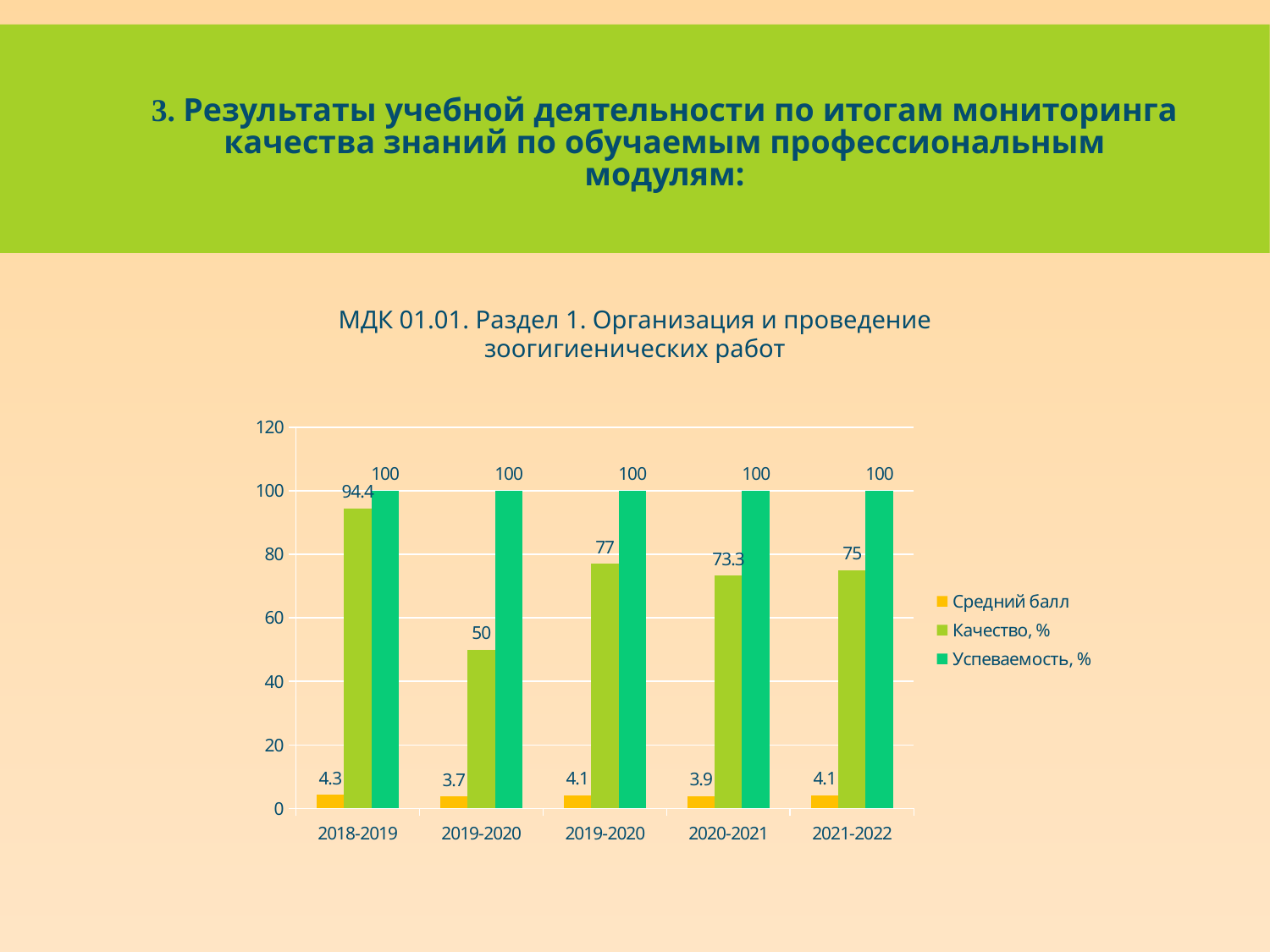
Which is larger, Качество, % for 2020-2021 or for 2021-2022? 2021-2022 What is the lowest value of Средний балл shown on the chart? 3.7 What is the value of Успеваемость, % for 2020-2021? 100 What is the Средний балл for 2021-2022? 4.1 How many series does the legend list? 3 What is the value of Качество, % for 2020-2021? 73.3 What is the value of Качество, % for 2018-2019? 94.4 What is the difference between Качество, % for 2018-2019 and for 2021-2022? 19.4 How many categories are shown on the x axis? 5 What is the difference between Средний балл for 2018-2019 and for 2020-2021? 0.4 Which category has the highest value of Качество, %? 2018-2019 What type of chart is shown on the slide? Bar chart